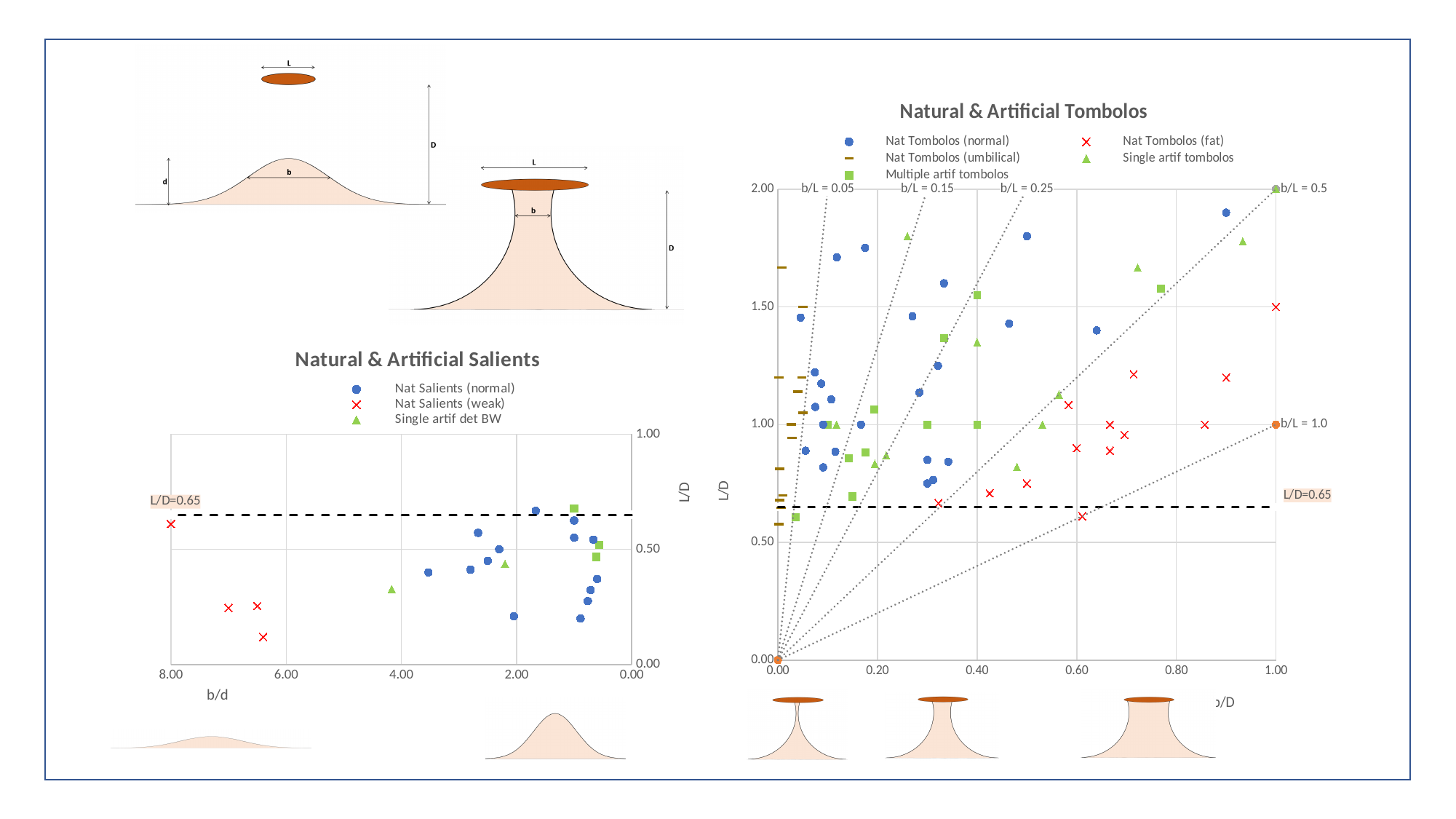
How many series does the legend of the 'Natural & Artificial Tombolos' chart list? 5 In the 'Natural & Artificial Salients' chart, what value is the horizontal dashed reference line labelled with? L/D=0.65 In the 'Natural & Artificial Tombolos' chart, what is the label of the steepest dotted reference line? b/L = 0.05 How many series does the legend of the 'Natural & Artificial Salients' chart list? 3 In the 'Natural & Artificial Salients' chart, is the L/D value of the 'Nat Salients (weak)' point at b/d = 8.00 greater or less than 1.00? less Which marker symbol does the legend of the 'Natural & Artificial Tombolos' chart use for 'Nat Tombolos (fat)'? red X What is the x-axis label of the 'Natural & Artificial Salients' chart? b/d What kind of chart is the 'Natural & Artificial Salients' chart? scatter chart In the 'Natural & Artificial Salients' chart, how many 'Nat Salients (weak)' points are plotted? 4 In the 'Natural & Artificial Tombolos' chart, is the L/D value of the 'Nat Tombolos (fat)' point at b/D = 1.00 greater or less than 1.00? greater In the 'Natural & Artificial Tombolos' chart, how many dotted b/L reference lines are drawn? 5